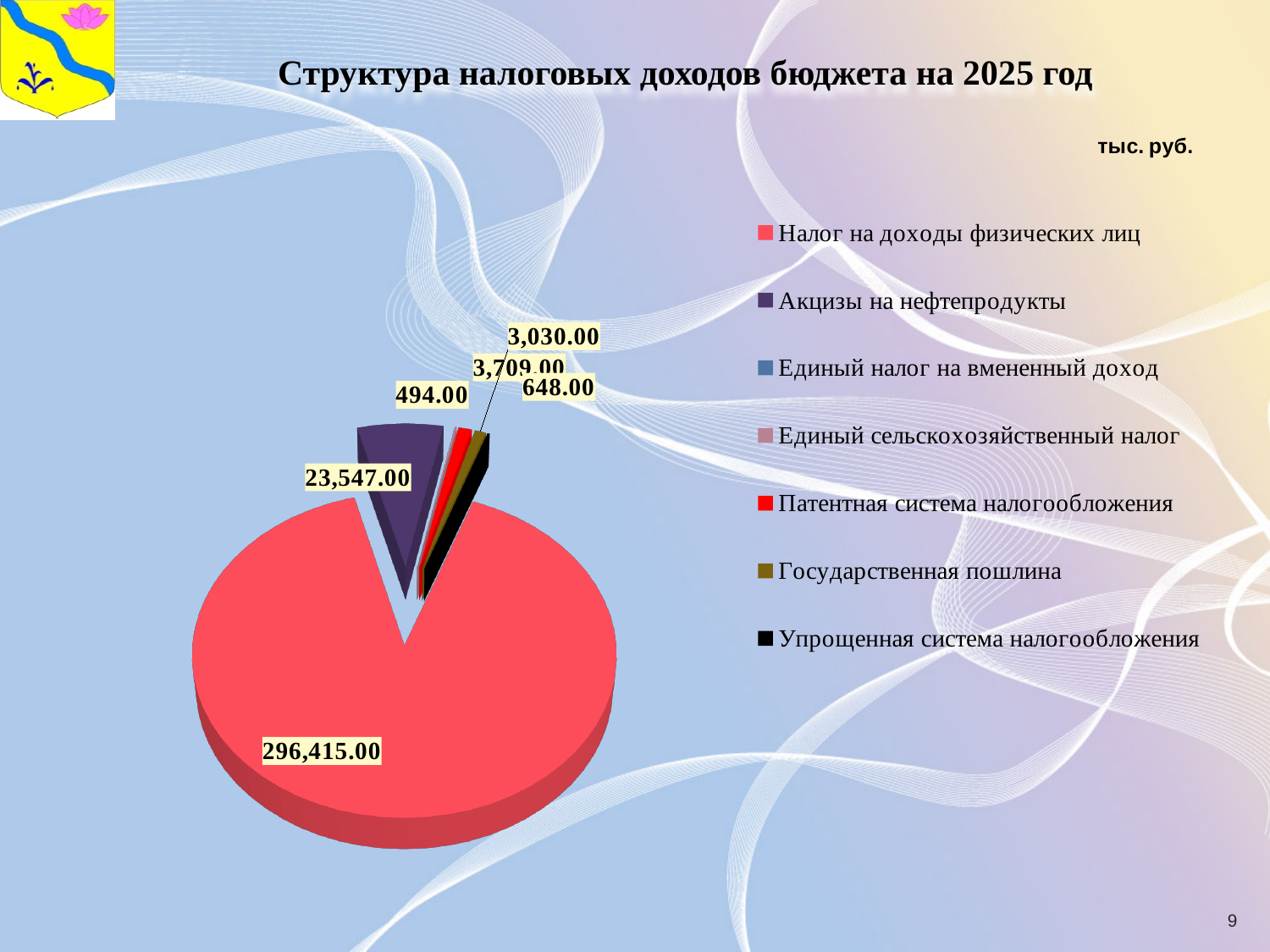
What is the difference between the values for Налог на доходы физических лиц and Акцизы на нефтепродукты? 272,868.00 Which is larger: Налог на доходы физических лиц or Акцизы на нефтепродукты? Налог на доходы физических лиц What type of chart is shown on the slide? Pie chart What is the smallest value printed on the chart? 494.00 How many entries does the legend list? 7 What is the value for Налог на доходы физических лиц? 296,415.00 What is the title of the chart? Структура налоговых доходов бюджета на 2025 год Which category has the largest slice of the pie? Налог на доходы физических лиц What is the value for Акцизы на нефтепродукты? 23,547.00 In what units are the values on the chart given? тыс. руб. What is the largest value printed on the chart? 296,415.00